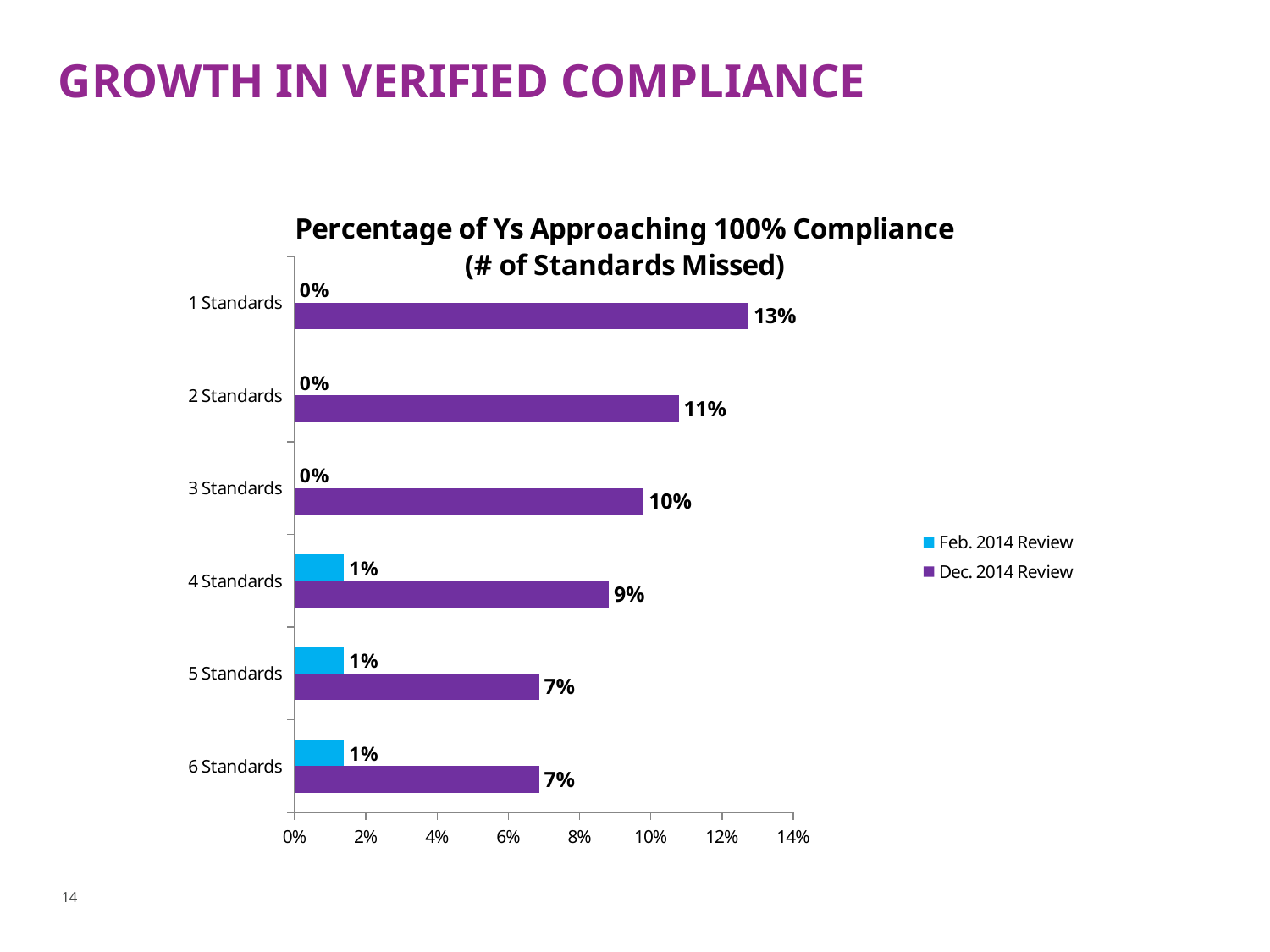
Which is larger for 5 Standards: the Feb. 2014 Review value or the Dec. 2014 Review value? Dec. 2014 Review How many series does the legend list? 2 What is the Dec. 2014 Review value for 1 Standards? 13% What is the difference between the Dec. 2014 Review values for 1 Standards and 2 Standards? 2% What is the Feb. 2014 Review value for 4 Standards? 1% What is the difference between the Dec. 2014 Review and Feb. 2014 Review values for 4 Standards? 8% What is the title of the chart? Percentage of Ys Approaching 100% Compliance (# of Standards Missed) What is the Feb. 2014 Review value for 2 Standards? 0% What kind of chart is shown on the slide? Bar chart Which category has the highest Dec. 2014 Review value? 1 Standards How many categories are shown on the chart? 6 What is the Dec. 2014 Review value for 3 Standards? 10%